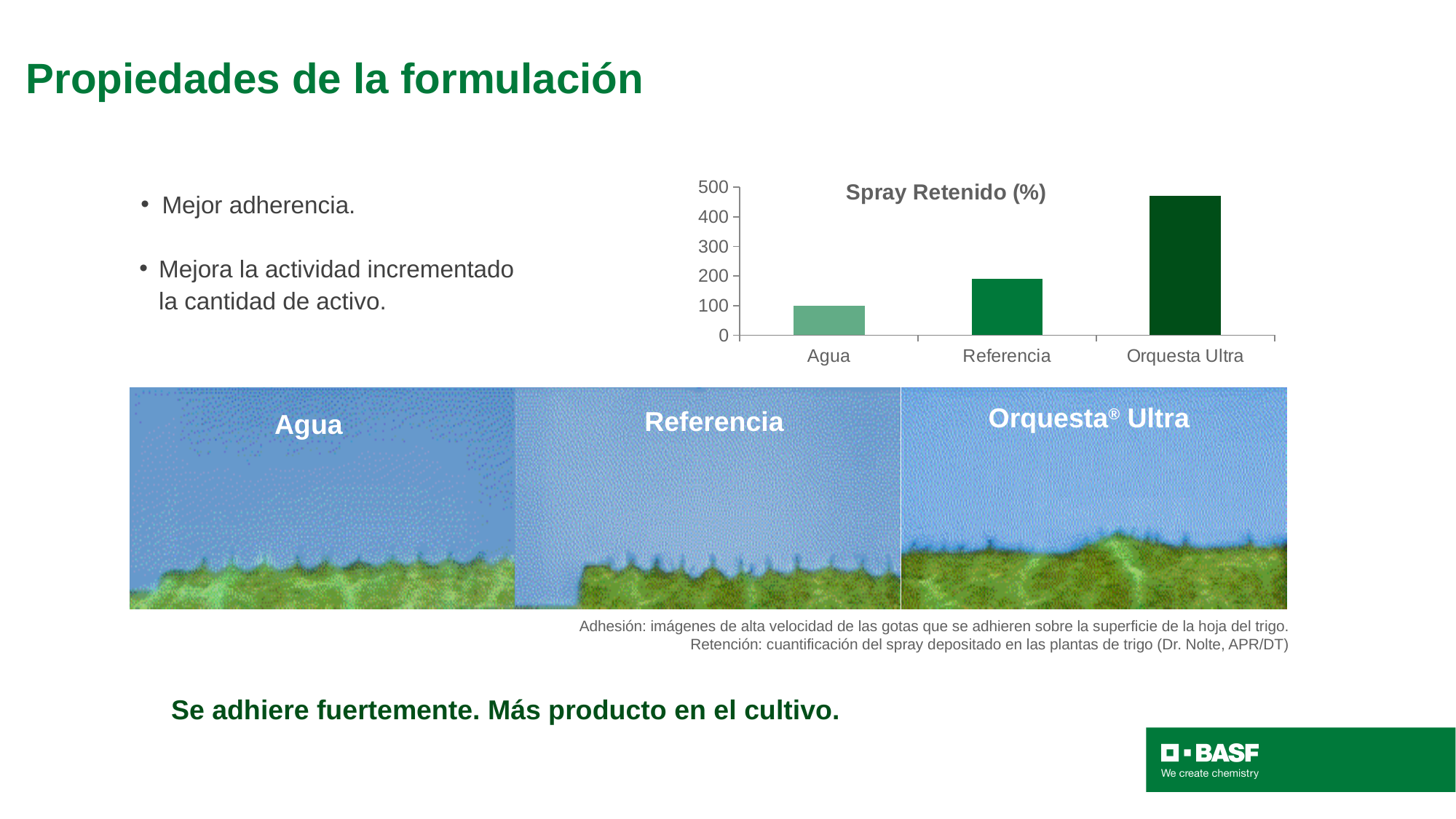
Is the value for Referencia greater or less than 100? greater Which category has the lowest value in the Spray Retenido (%) chart? Agua What kind of chart is shown on the slide? bar chart How many categories are shown on the x axis of the chart? 3 What is the title of the chart? Spray Retenido (%) Which has a higher value, Referencia or Agua? Referencia Which category has the highest value in the Spray Retenido (%) chart? Orquesta Ultra Do the values rise or fall from Agua to Orquesta Ultra along the x axis? rise Which has a higher value, Orquesta Ultra or Referencia? Orquesta Ultra Is the value for Orquesta Ultra greater or less than 400? greater What is the highest value shown on the y axis of the chart? 500